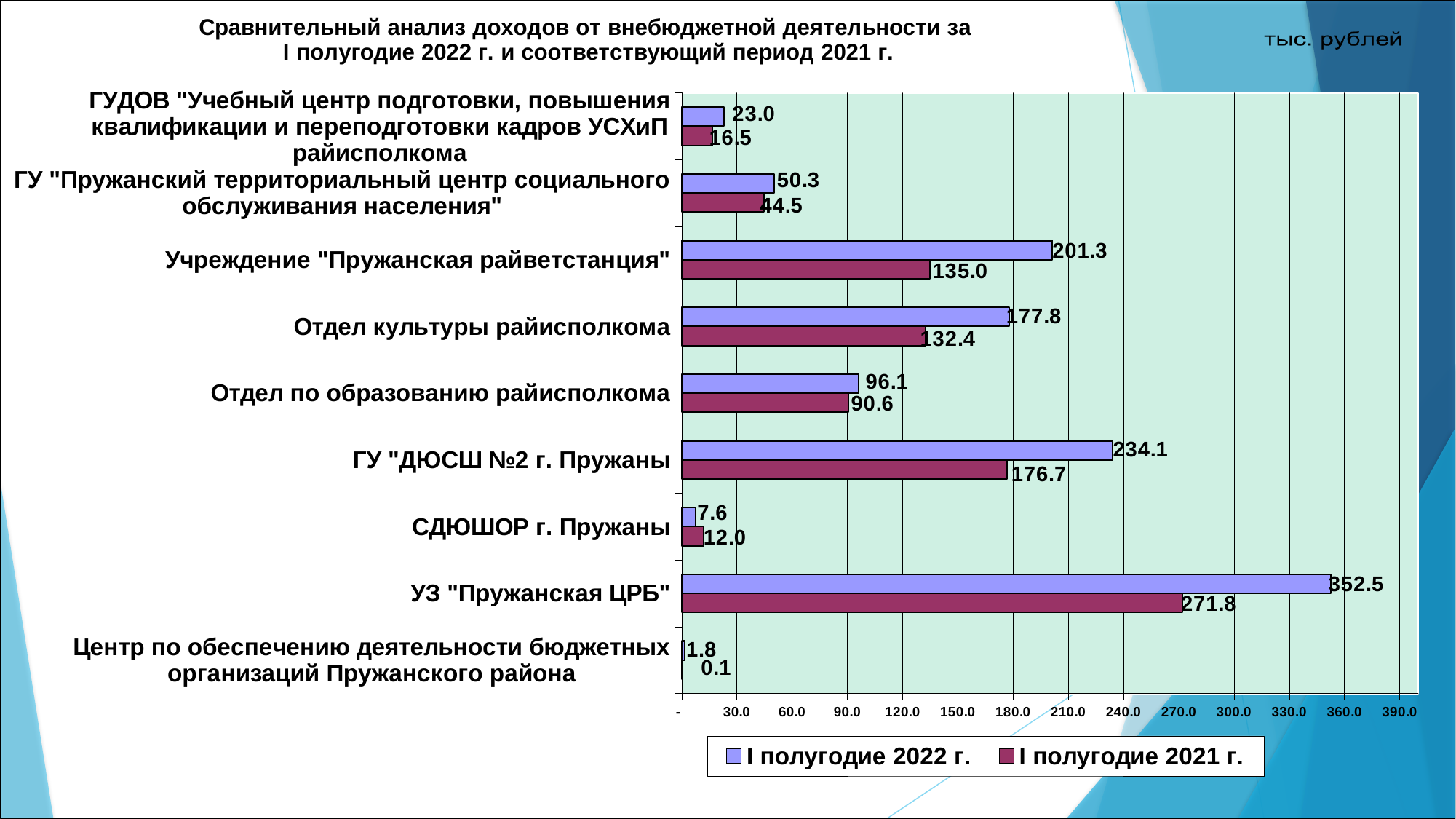
Is the I полугодие 2022 г. value for Учреждение "Пружанская райветстанция" greater or less than 180.0? greater Which category has the highest value in the I полугодие 2021 г. series? УЗ "Пружанская ЦРБ" How many categories (organisations) are shown on the chart? 9 What is the value for УЗ "Пружанская ЦРБ" in the I полугодие 2022 г. series? 352.5 What kind of chart is shown on the slide? Bar chart What unit is indicated in the top right corner of the slide? тыс. рублей For СДЮШОР г. Пружаны, which series has the larger value: I полугодие 2022 г. or I полугодие 2021 г.? I полугодие 2021 г. What is the difference between the I полугодие 2022 г. and I полугодие 2021 г. values for ГУ "ДЮСШ №2 г. Пружаны"? 57.4 Which category has the lowest value in the I полугодие 2022 г. series? Центр по обеспечению деятельности бюджетных организаций Пружанского района What is the value for СДЮШОР г. Пружаны in the I полугодие 2022 г. series? 7.6 How many series does the legend list? 2 What is the value for Отдел культуры райисполкома in the I полугодие 2021 г. series? 132.4